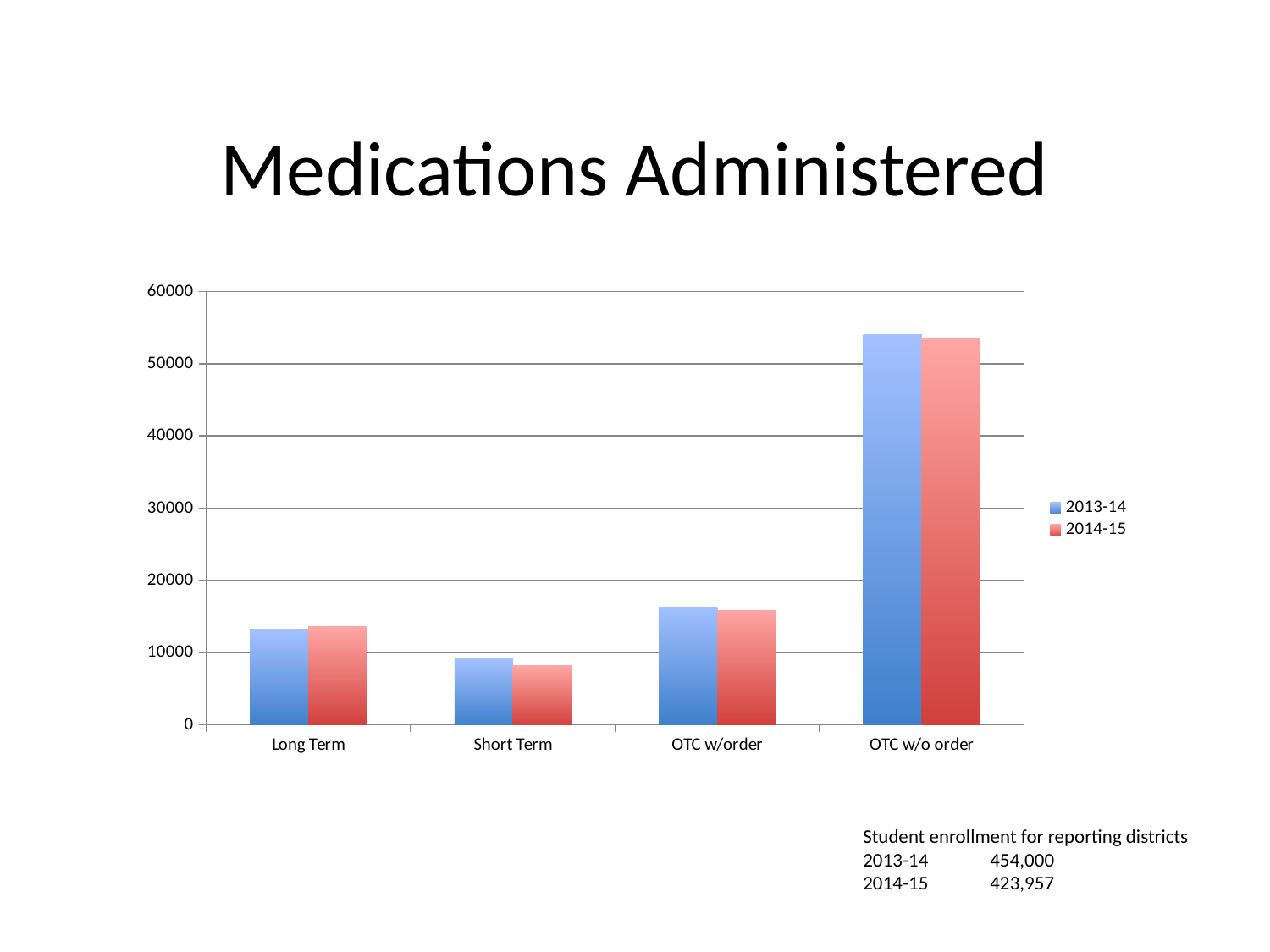
Is the 2013-14 value for OTC w/o order greater or less than 50000? greater Is the 2013-14 value for Long Term greater or less than 10000? greater Which category has the lowest number of medications administered? Short Term For Short Term, which series has the larger value, 2013-14 or 2014-15? 2013-14 What kind of chart is shown on the slide? bar chart Is the 2013-14 value for OTC w/order greater or less than 20000? less How many series does the legend list? 2 What is the title of the chart? Medications Administered Which category has the highest number of medications administered? OTC w/o order For 2013-14, which is larger, OTC w/order or OTC w/o order? OTC w/o order How many categories are shown on the x axis? 4